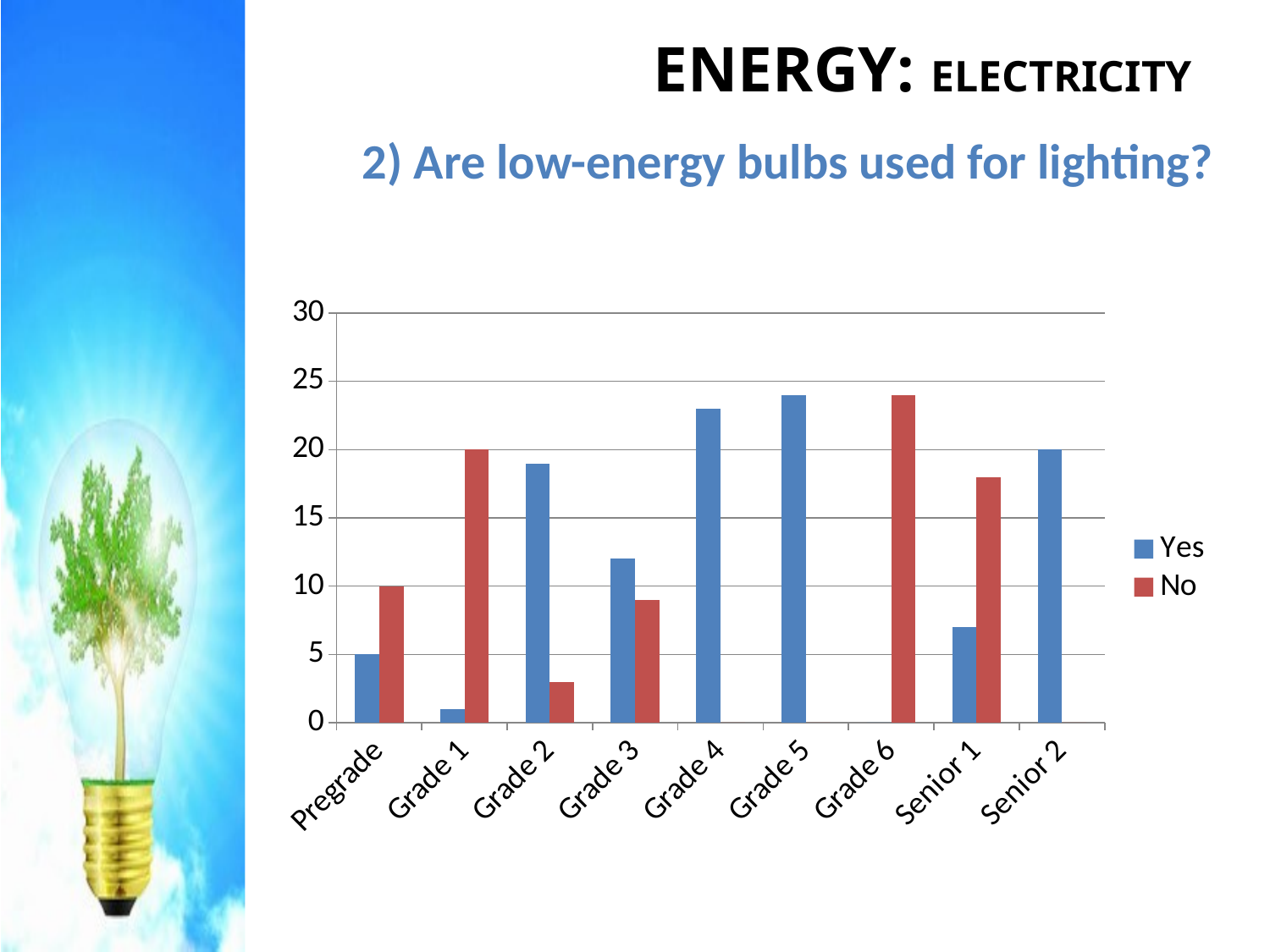
What is the Yes value for Pregrade? 5 What kind of chart is shown on the slide? bar chart What is the No value for Grade 1? 20 How many grade categories are shown on the x axis? 9 How many series does the legend list? 2 What is the difference between the No and Yes values for Pregrade? 5 Is the Yes value for Grade 4 greater or less than 20? greater Which colour represents the Yes series in the legend? blue Which category has the lowest Yes value? Grade 6 Which category has the highest No value? Grade 6 For Grade 2, which is larger, the Yes value or the No value? Yes What is the Yes value for Senior 2? 20